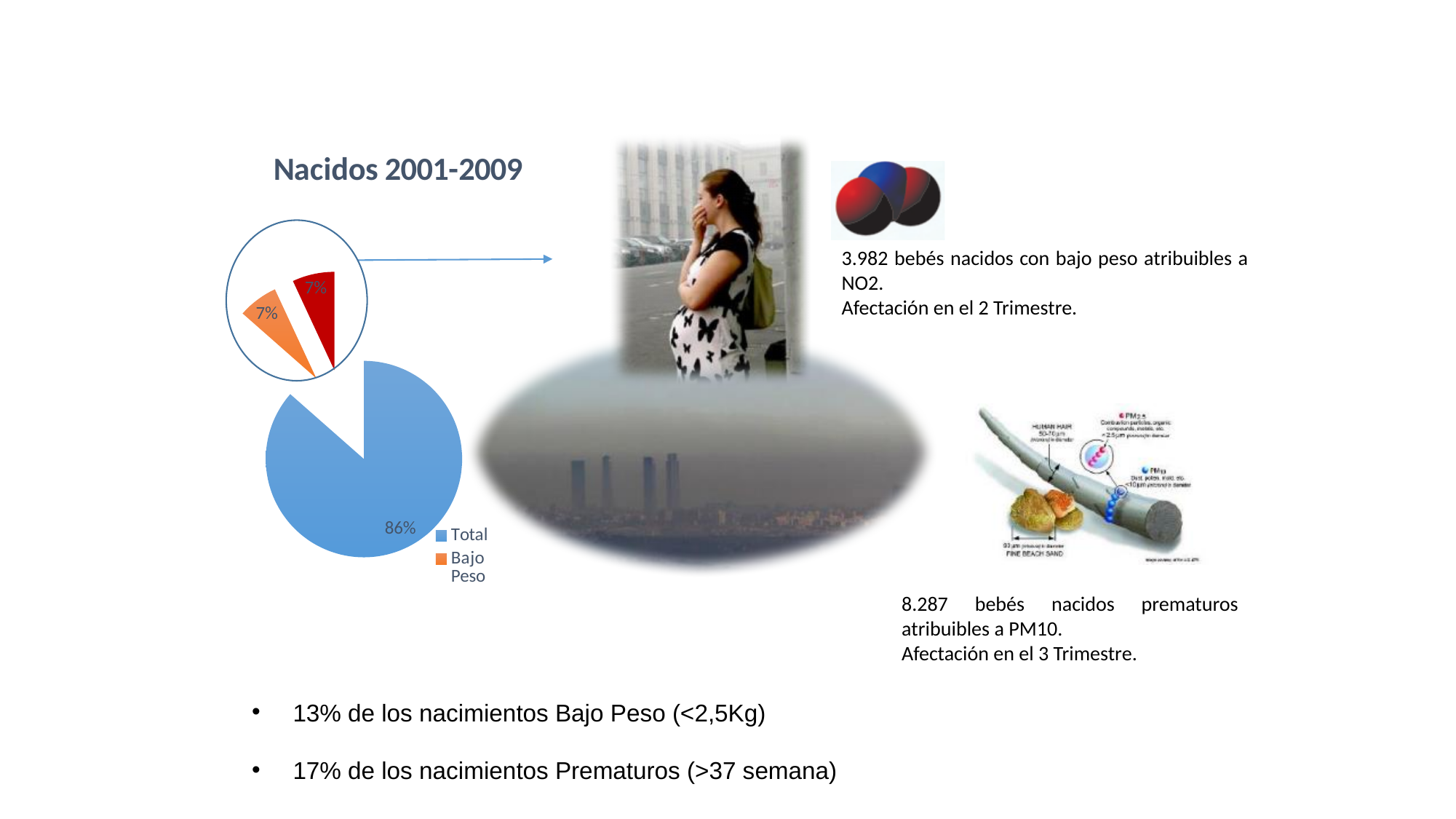
What share of the pie does the Total slice represent? 86% Which is larger, the Total slice or the Bajo Peso slice? Total What is the combined share of the two small slices labelled 7%? 14% What share of the pie does the Bajo Peso slice represent? 7% What kind of chart is shown on the slide? pie chart What colour is the Total slice of the pie? blue Is the share of the Total slice greater or less than 50%? greater What is the title of the chart? Nacidos 2001-2009 What is the difference in percentage points between the Total slice and the Bajo Peso slice? 79% How many slices does the pie chart have? 3 Which slice of the pie is the largest? Total